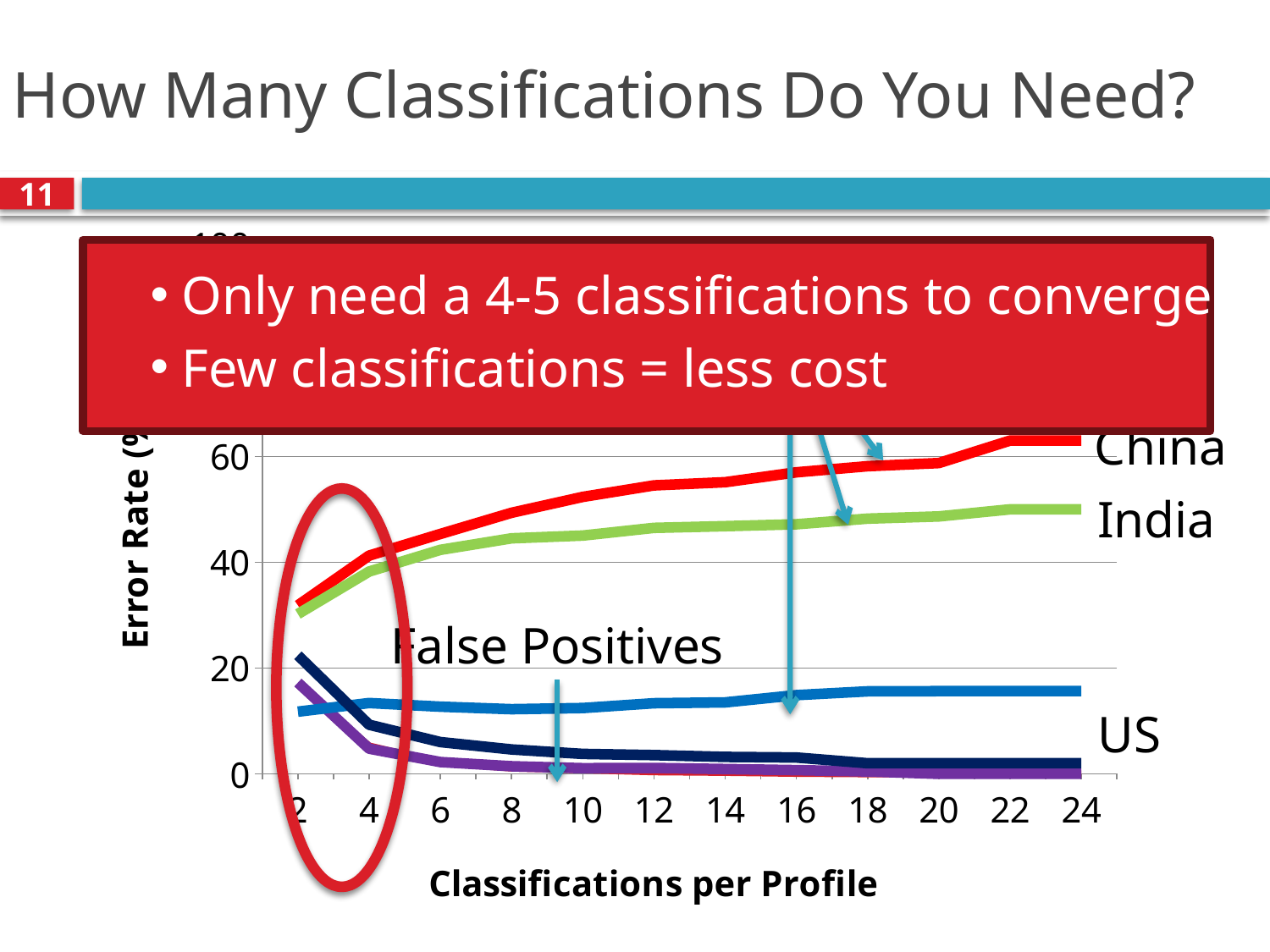
What is the label of the y axis of the chart? Error Rate (%) Is the error rate for China at 2 classifications per profile greater or less than 40? less What kind of chart is shown on the slide? line chart Is the error rate for India at 24 classifications per profile greater or less than 40? greater Which labelled line has the highest error rate at 24 classifications per profile? China What is the label of the x axis of the chart? Classifications per Profile How many lines are plotted on the chart? 6 At 24 classifications per profile, which line is higher, China or India? China Does the India line rise or fall as the number of classifications per profile increases? rises Does the China line rise or fall as the number of classifications per profile increases? rises How many tick labels are shown on the x axis? 12 Is the error rate for China at 12 classifications per profile greater or less than 40? greater